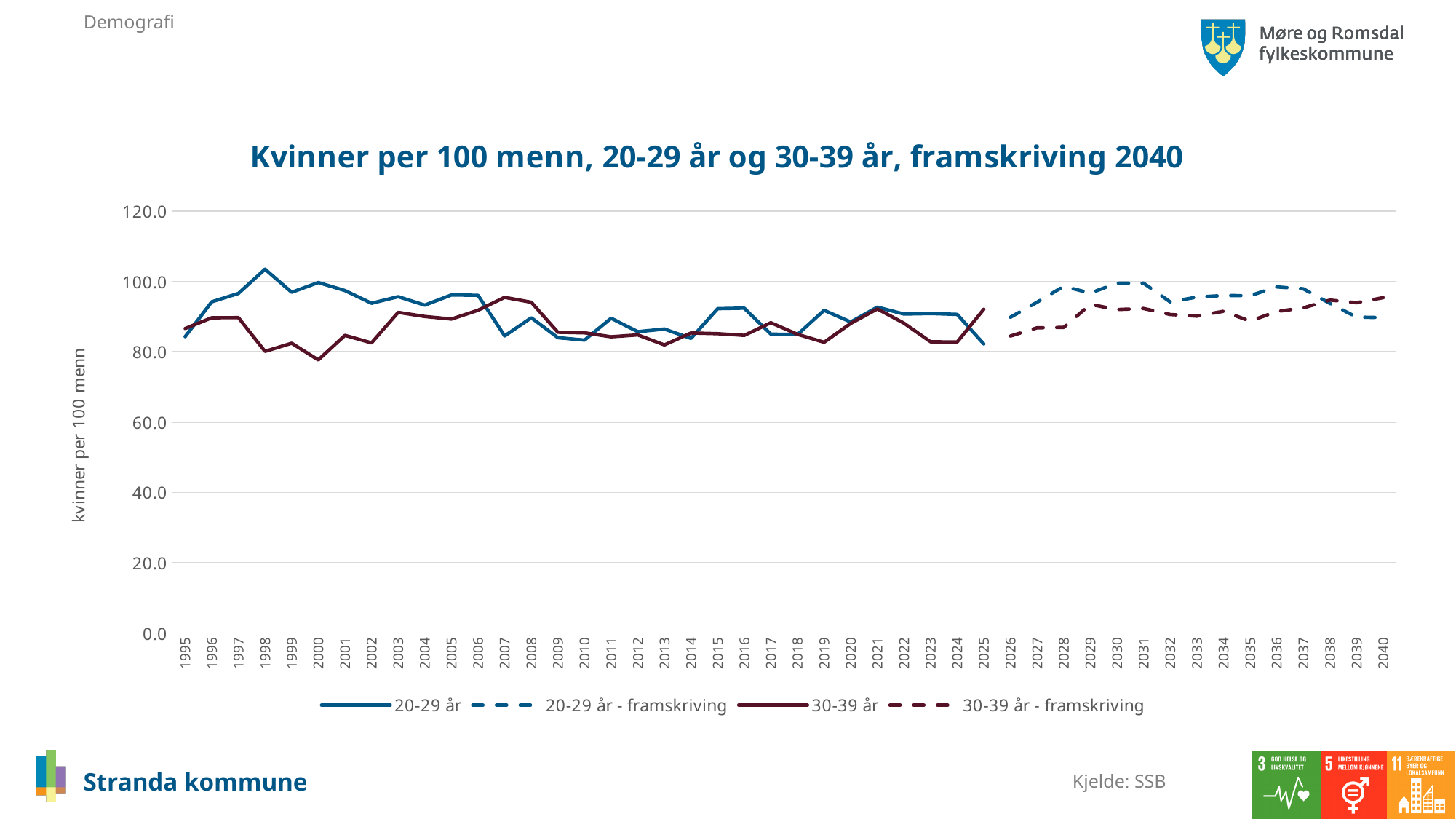
How many years are shown along the x axis? 46 What kind of chart is shown on the slide? line chart Does the '30-39 år - framskriving' line generally rise or fall from 2026 to 2040? rise How many series does the legend list? 4 In 1998, which is larger: the value for '20-29 år' or for '30-39 år'? 20-29 år What is the label on the vertical axis? kvinner per 100 menn In which year does the solid '20-29 år' line reach its highest value? 1998 In which year does the solid '30-39 år' line reach its lowest value? 2000 Is the value for '20-29 år' in 1998 greater or less than 100? greater Is the value for '30-39 år' in 2000 greater or less than 80? less Is the value for '30-39 år' in 2007 greater or less than 100? less In 2007, which is larger: the value for '20-29 år' or for '30-39 år'? 30-39 år